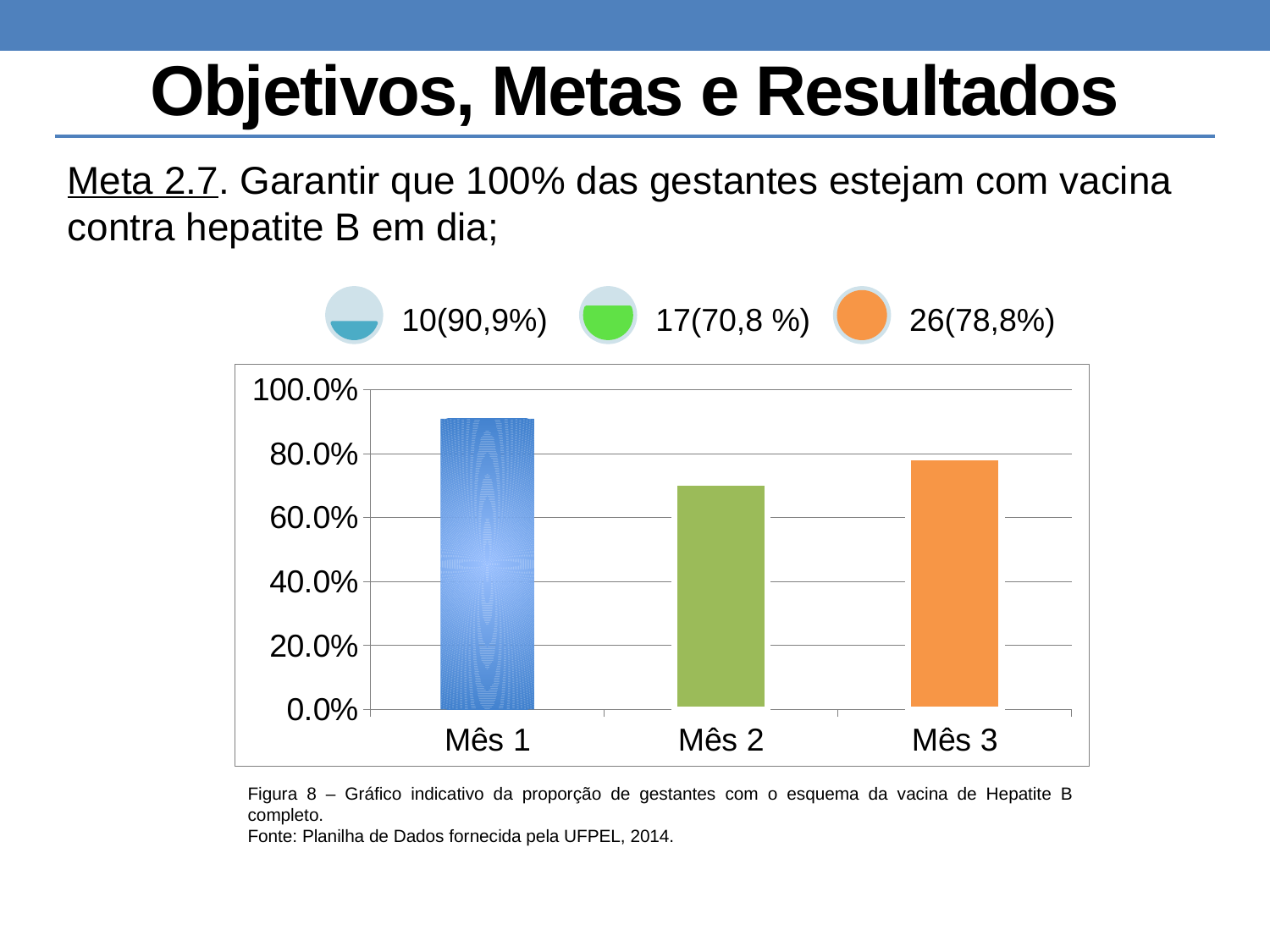
What colour is the bar for Mês 3? orange What kind of chart is shown on the slide? bar chart Is the value for Mês 3 greater or less than 80.0%? less Does the value rise or fall from Mês 1 to Mês 2? fall What percentage is shown for Mês 3 in the labels above the chart? 78,8% How many categories (months) are plotted on the x axis of the chart? 3 What percentage is shown for Mês 2 in the labels above the chart? 70,8 % Which month has the highest bar in the chart? Mês 1 Is the value for Mês 1 greater or less than 80.0%? greater Which month has the lowest bar in the chart? Mês 2 Which is larger, the value for Mês 2 or the value for Mês 3? Mês 3 What percentage is shown for Mês 1 in the labels above the chart? 90,9%